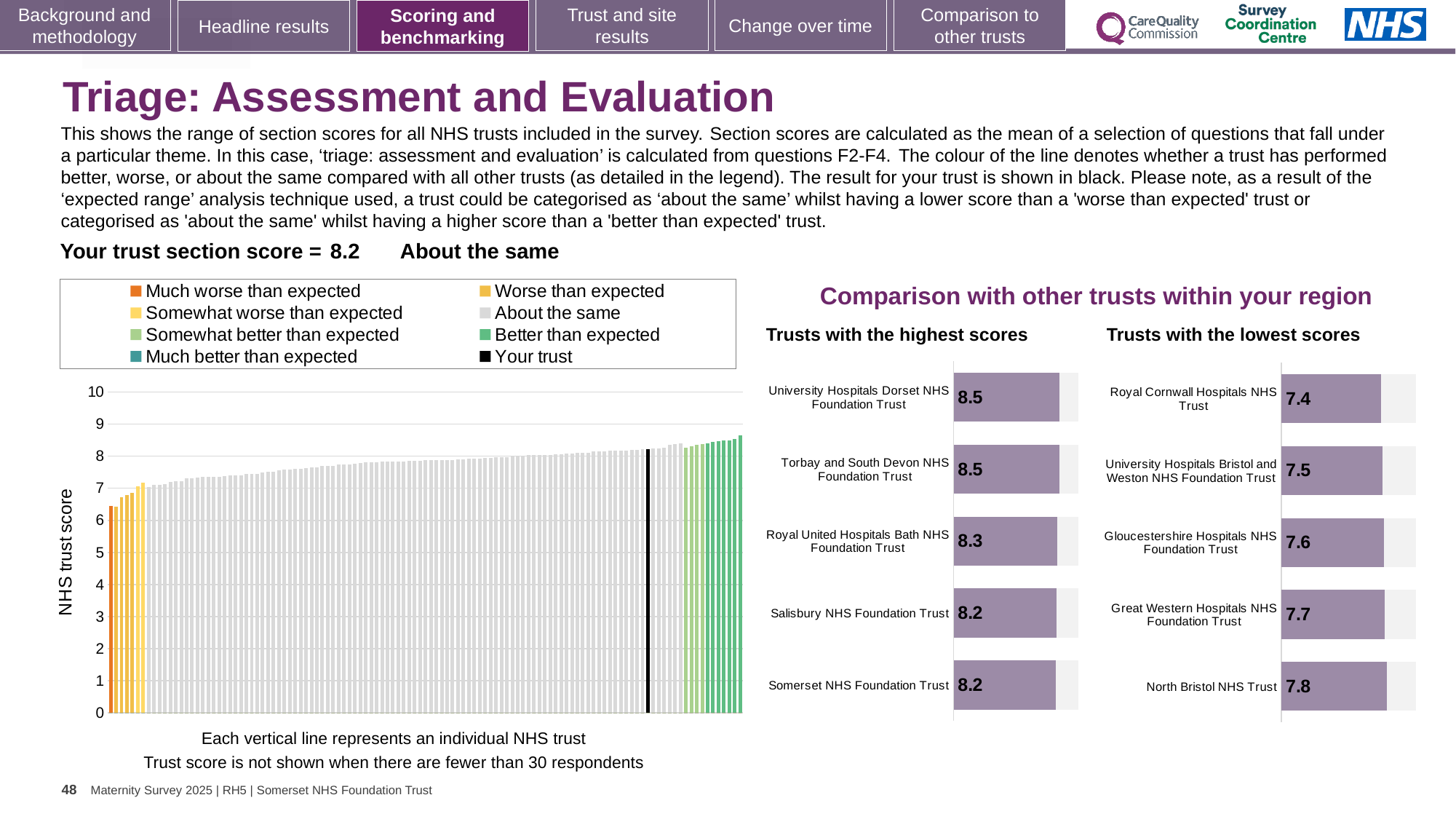
How many trusts are shown in the 'Trusts with the highest scores' chart? 5 What kind of chart is the main chart on the left showing all NHS trusts? Bar chart In the 'Trusts with the lowest scores' chart, which trust has the highest score? North Bristol NHS Trust In the 'Trusts with the lowest scores' chart, what is the difference between the scores of North Bristol NHS Trust and Royal Cornwall Hospitals NHS Trust? 0.4 In the 'Trusts with the lowest scores' chart, what is the score for Gloucestershire Hospitals NHS Foundation Trust? 7.6 In the 'Trusts with the highest scores' chart, what is the difference between the scores of University Hospitals Dorset NHS Foundation Trust and Somerset NHS Foundation Trust? 0.3 How many entries does the legend of the main chart on the left list? 8 In the main chart on the left, is the value of the leftmost (orange) bar greater or less than 7? less In the main chart on the left, do the trust scores rise or fall from left to right? Rise In the 'Trusts with the lowest scores' chart, which has the higher score: Gloucestershire Hospitals NHS Foundation Trust or Great Western Hospitals NHS Foundation Trust? Great Western Hospitals NHS Foundation Trust In the 'Trusts with the lowest scores' chart, which trust has the lowest score? Royal Cornwall Hospitals NHS Trust In the 'Trusts with the highest scores' chart, what is the score for Royal United Hospitals Bath NHS Foundation Trust? 8.3